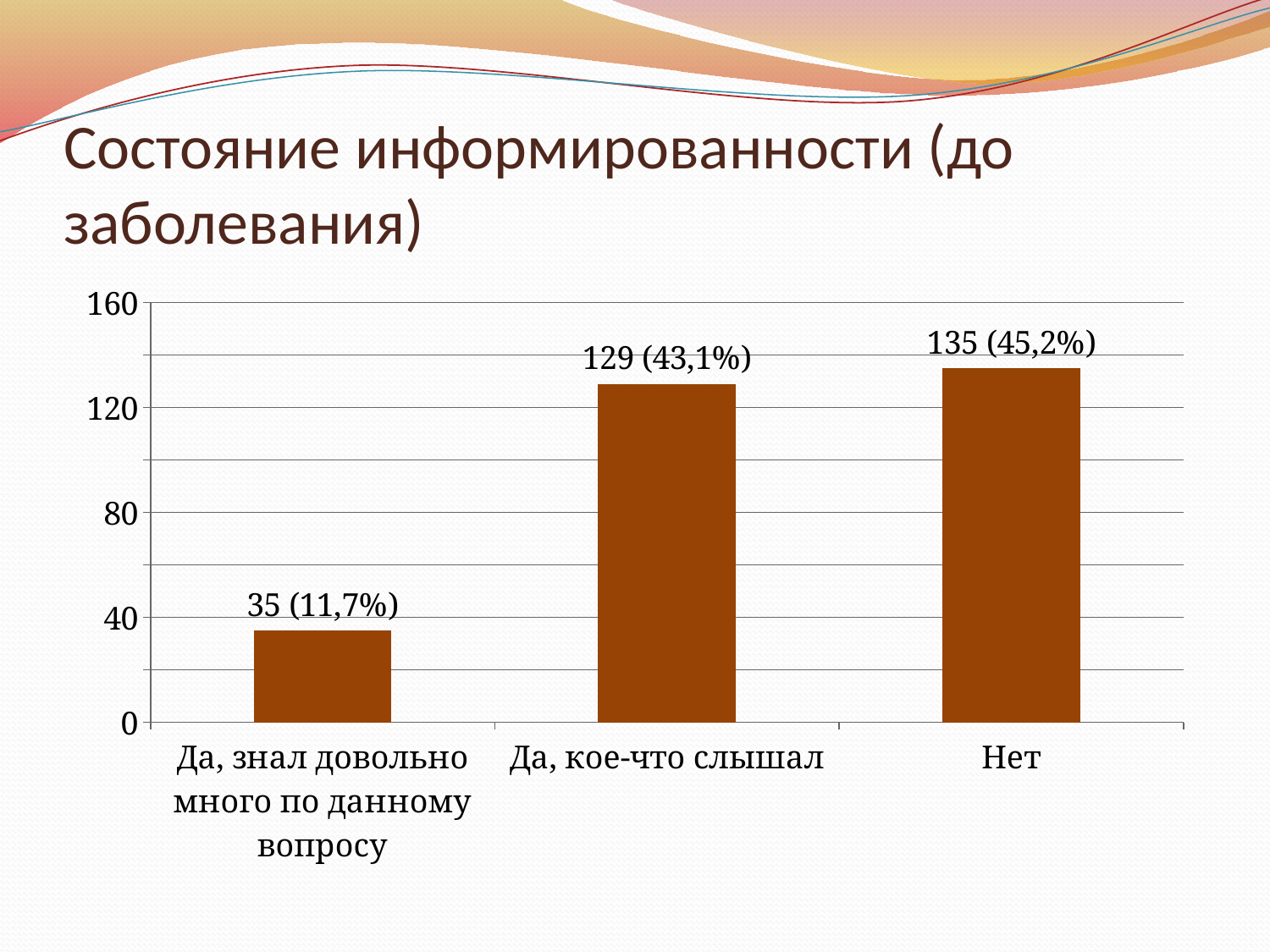
What is the difference between the counts for "Нет" and "Да, кое-что слышал"? 6 What is the value for the category "Нет"? 135 (45,2%) Which category has the highest value? Нет What is the value for the category "Да, знал довольно много по данному вопросу"? 35 (11,7%) What is the value for the category "Да, кое-что слышал"? 129 (43,1%) How many categories are shown in the chart? 3 What type of chart is shown on the slide? bar chart Which category has the lowest value? Да, знал довольно много по данному вопросу Is the value for "Да, знал довольно много по данному вопросу" greater or less than 40? less Which is larger: the value for "Да, кое-что слышал" or for "Да, знал довольно много по данному вопросу"? Да, кое-что слышал What is the difference between the counts for "Да, кое-что слышал" and "Да, знал довольно много по данному вопросу"? 94 What is the title of the slide? Состояние информированности (до заболевания)